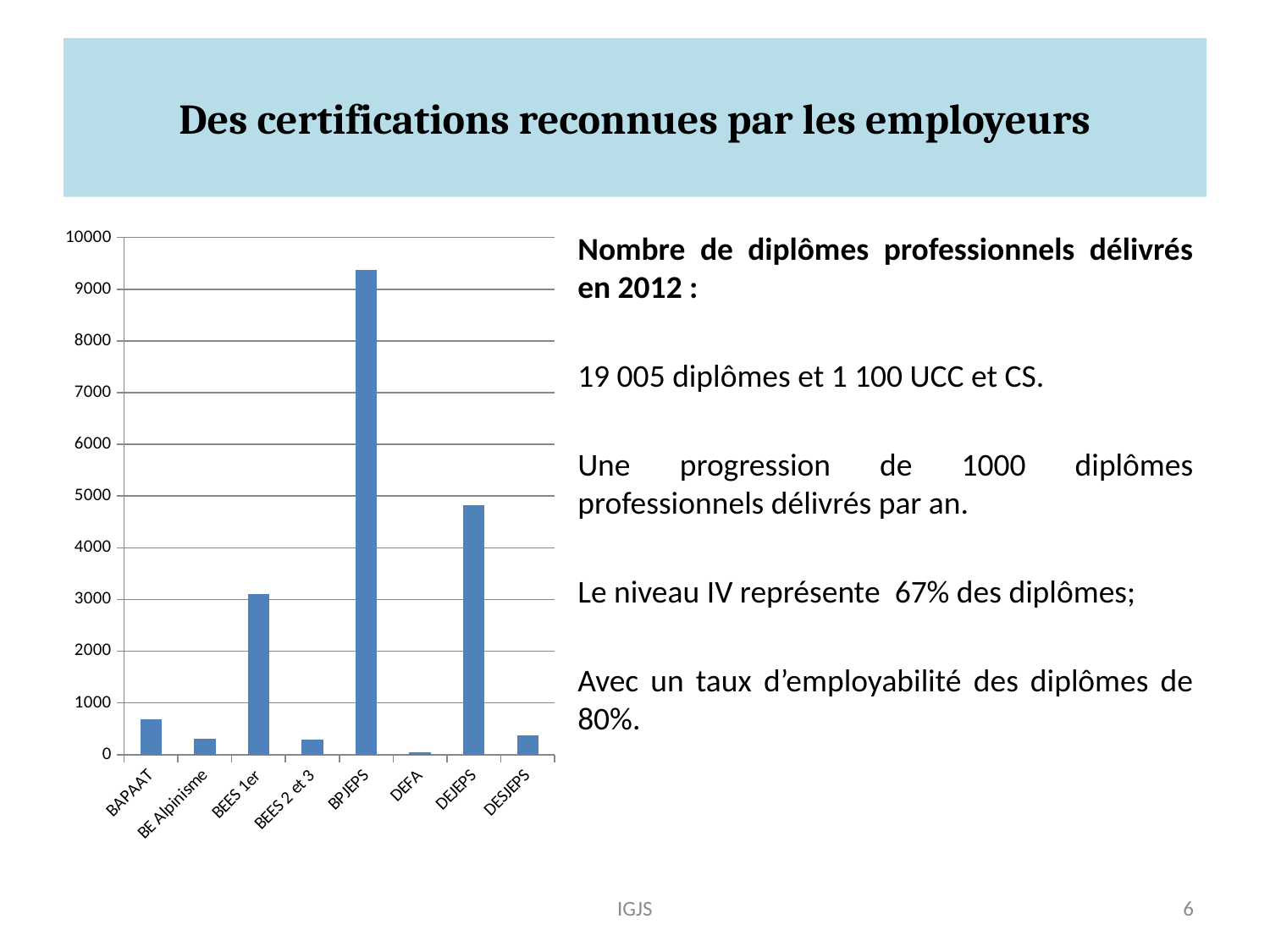
What colour are the bars in the chart? blue Which is larger, the value for BAPAAT or the value for DESJEPS? BAPAAT Is the value for BPJEPS greater or less than 9000? greater Which category has the highest bar in the chart? BPJEPS How many categories are shown on the x axis of the chart? 8 What is the highest value shown on the vertical axis of the chart? 10000 Which is larger, the value for DEJEPS or the value for BEES 1er? DEJEPS Is the value for DEJEPS greater or less than 5000? less Which category has the lowest bar in the chart? DEFA Is the value for BAPAAT greater or less than 1000? less What kind of chart is shown on the slide? bar chart